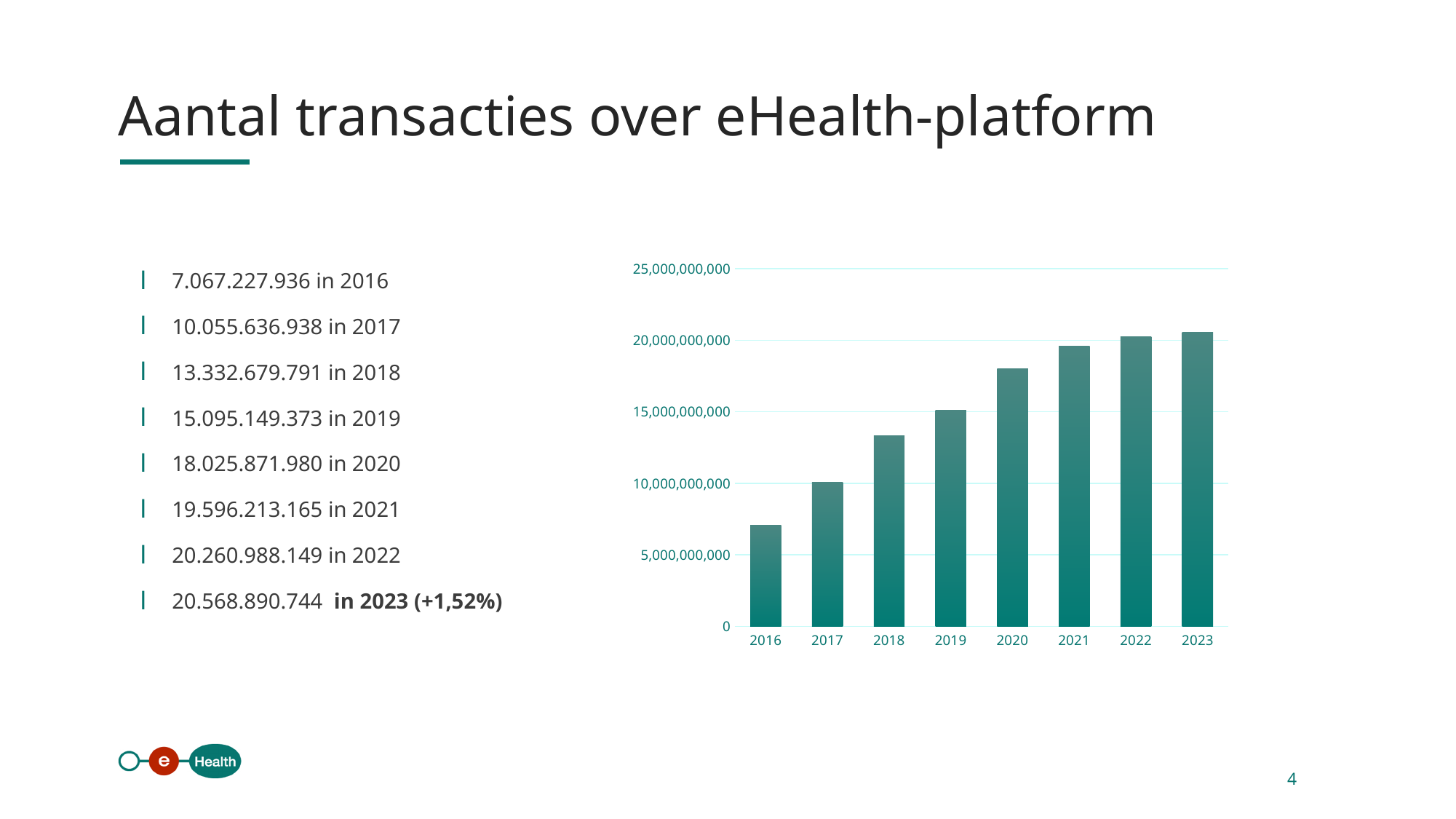
Do the values in the chart rise or fall from 2016 to 2023? rise What is the title of the slide containing the chart? Aantal transacties over eHealth-platform How many years are shown on the x axis of the chart? 8 Is the value for 2018 greater or less than 15,000,000,000? less According to the slide, how many transactions were there in 2023? 20.568.890.744 Which year has the highest number of transactions in the chart? 2023 Is the value for 2016 greater or less than 10,000,000,000? less What kind of chart is shown on the slide? bar chart Which year has the lowest number of transactions in the chart? 2016 Which year has the larger value, 2019 or 2020? 2020 Is the value for 2020 greater or less than 15,000,000,000? greater According to the slide, how many transactions were there in 2016? 7.067.227.936